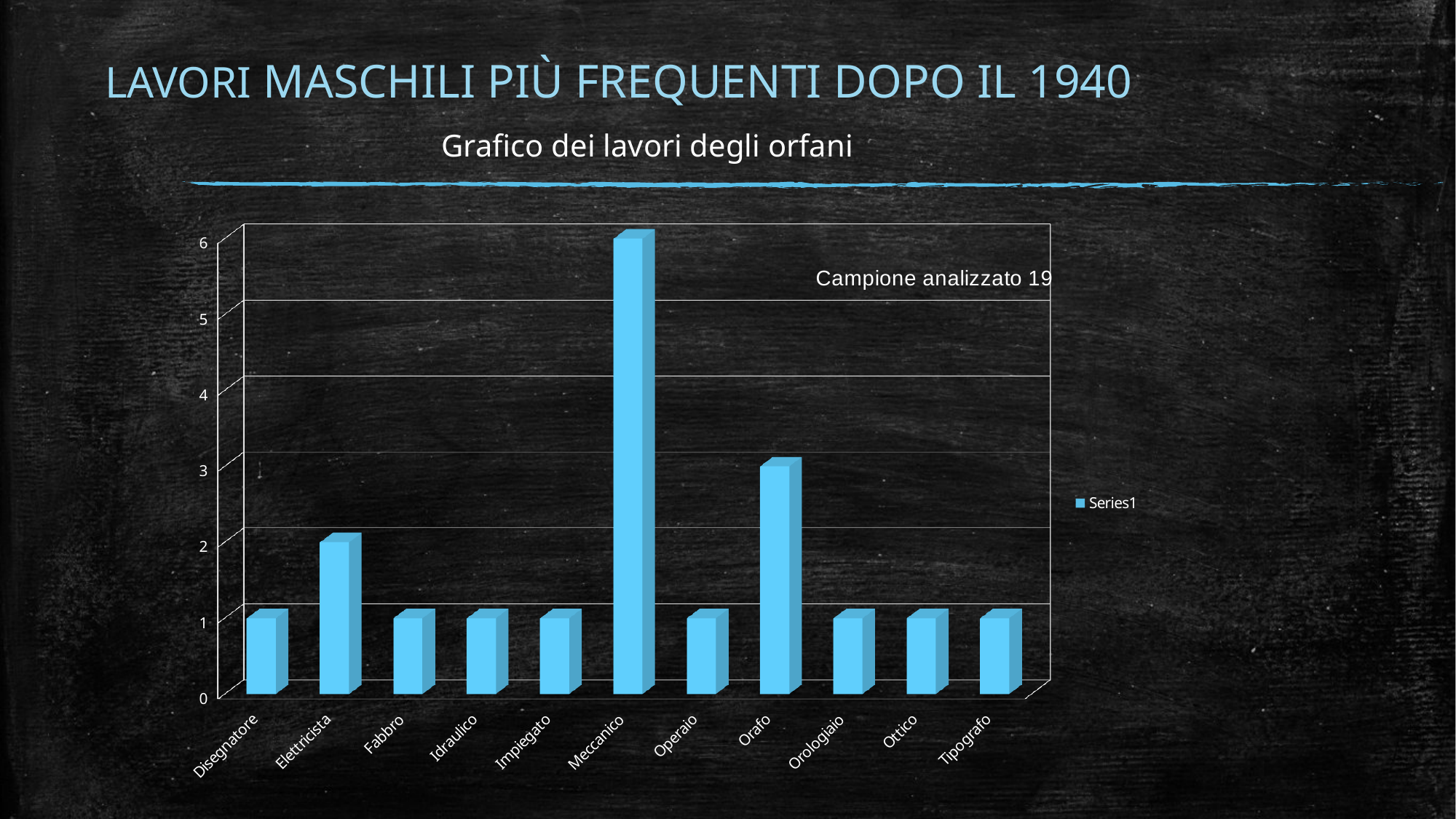
Which category has the highest value in the chart? Meccanico Which is larger, the value for Orafo or the value for Elettricista? Orafo Is the value for Meccanico greater or less than 5? greater What type of chart is shown on the slide? Bar chart What is the difference between the values for Meccanico and Orafo? 3 What is the name of the series shown in the legend? Series1 How many categories are shown on the x axis of the chart? 11 What is the value for Meccanico? 6 What is the value for Tipografo? 1 What is the value for Orafo? 3 What is the value for Elettricista? 2 How many series does the legend list? 1